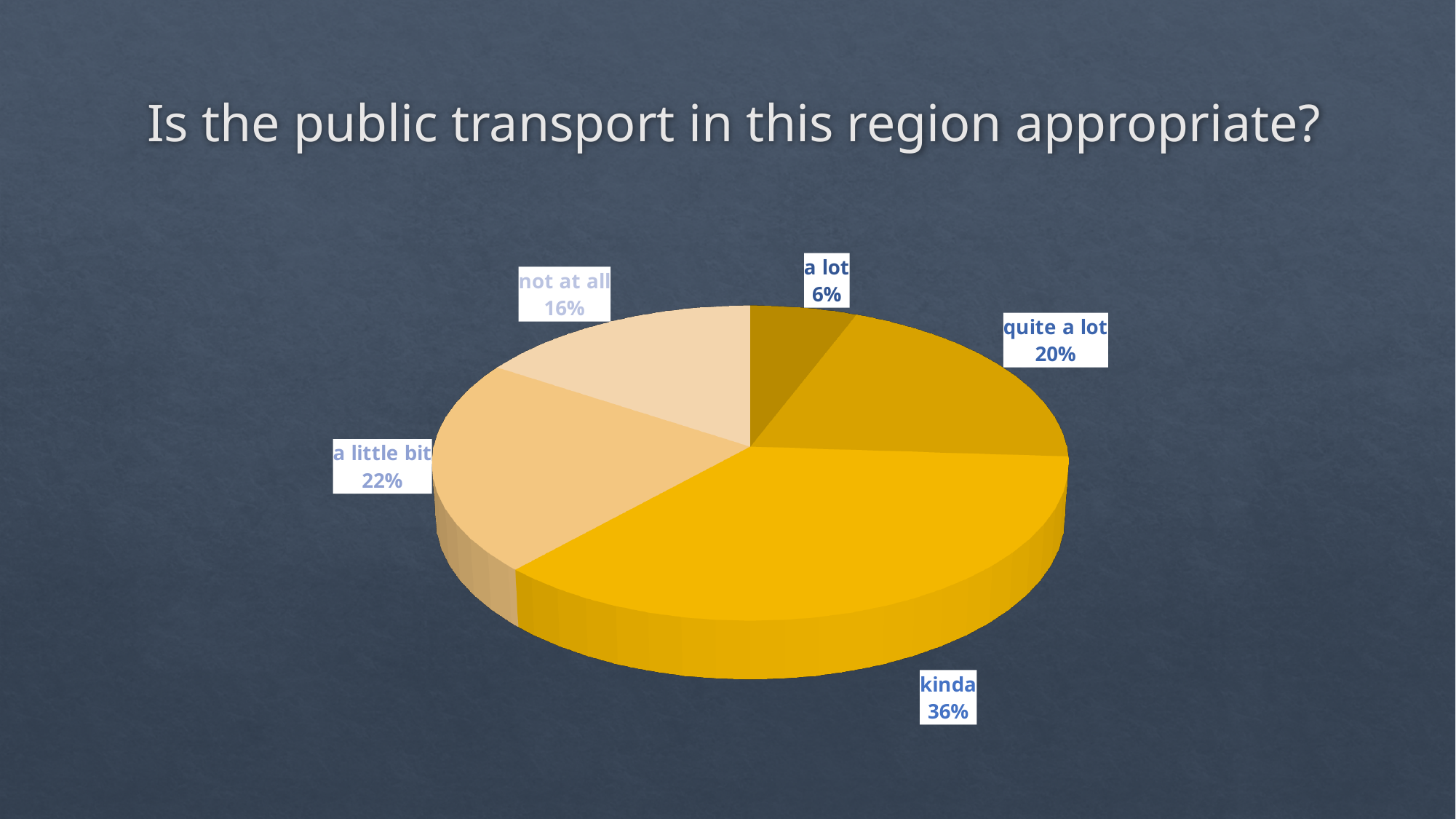
Which is larger, the share for "a little bit" or the share for "not at all"? a little bit What percentage of respondents answered "kinda"? 36% Which response has the smallest share of the pie? a lot What percentage of respondents answered "not at all"? 16% How many response categories are shown in the pie chart? 5 What percentage of respondents answered "a lot"? 6% What is the difference in percentage points between "kinda" and "quite a lot"? 16 What percentage of respondents answered "a little bit"? 22% What is the combined share of "a lot" and "quite a lot"? 26% What is the title of the slide? Is the public transport in this region appropriate? What kind of chart is shown on the slide? pie chart Which response has the largest share of the pie? kinda